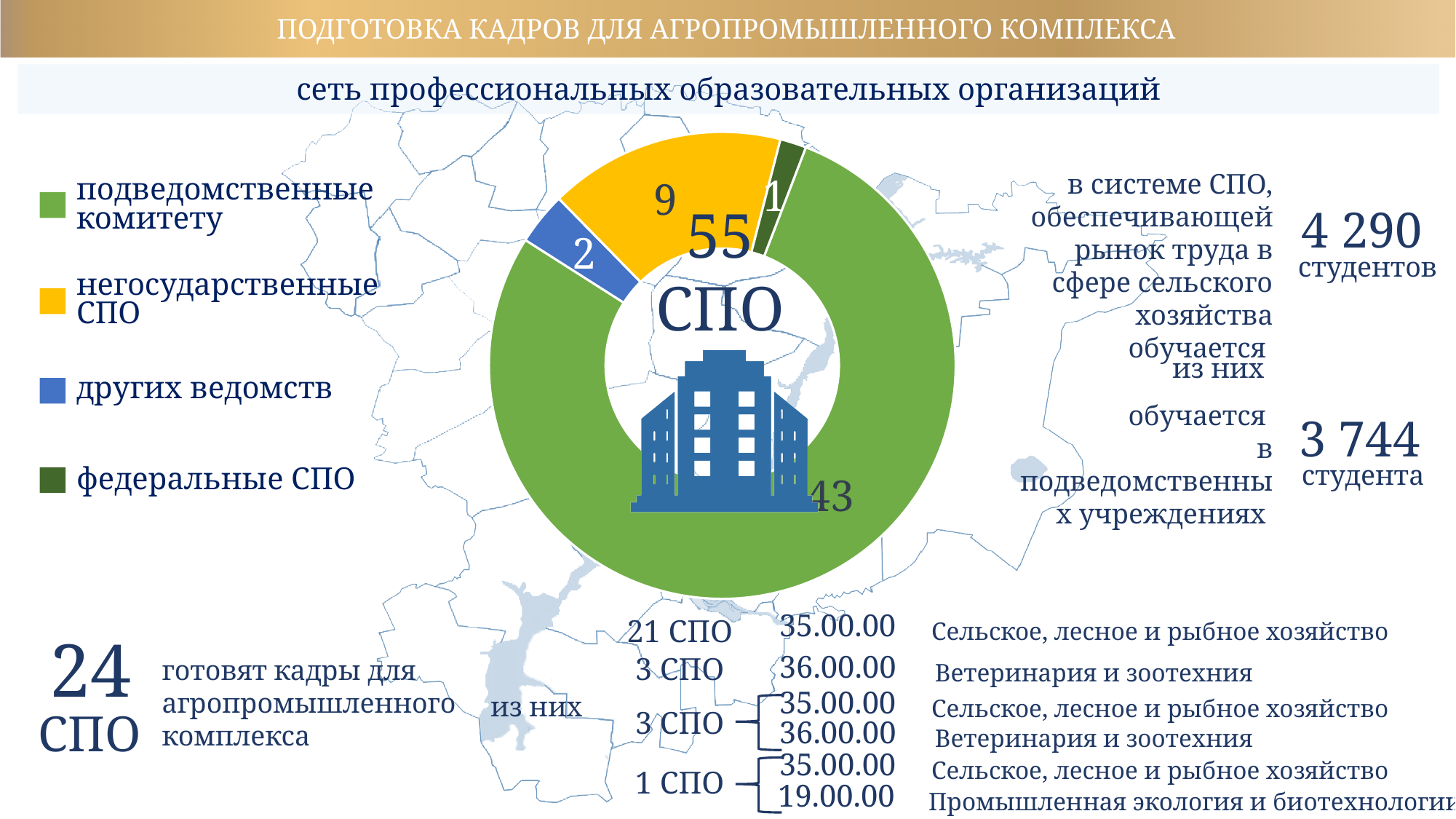
What is the value for "подведомственные комитету" in the donut chart? 43 How many categories does the donut chart show? 4 Which category has the largest value in the donut chart? подведомственные комитету Which category has the smallest value in the donut chart? федеральные СПО What is the value for "негосударственные СПО" in the donut chart? 9 Which is larger: the value for "негосударственные СПО" or for "других ведомств"? негосударственные СПО What type of chart is shown on the slide? Pie chart (donut) What colour represents "негосударственные СПО" in the donut chart? Yellow What is the difference between the values for "подведомственные комитету" and "негосударственные СПО"? 34 What is the value for "федеральные СПО" in the donut chart? 1 What total number is shown in the centre of the donut chart? 55 What is the value for "других ведомств" in the donut chart? 2